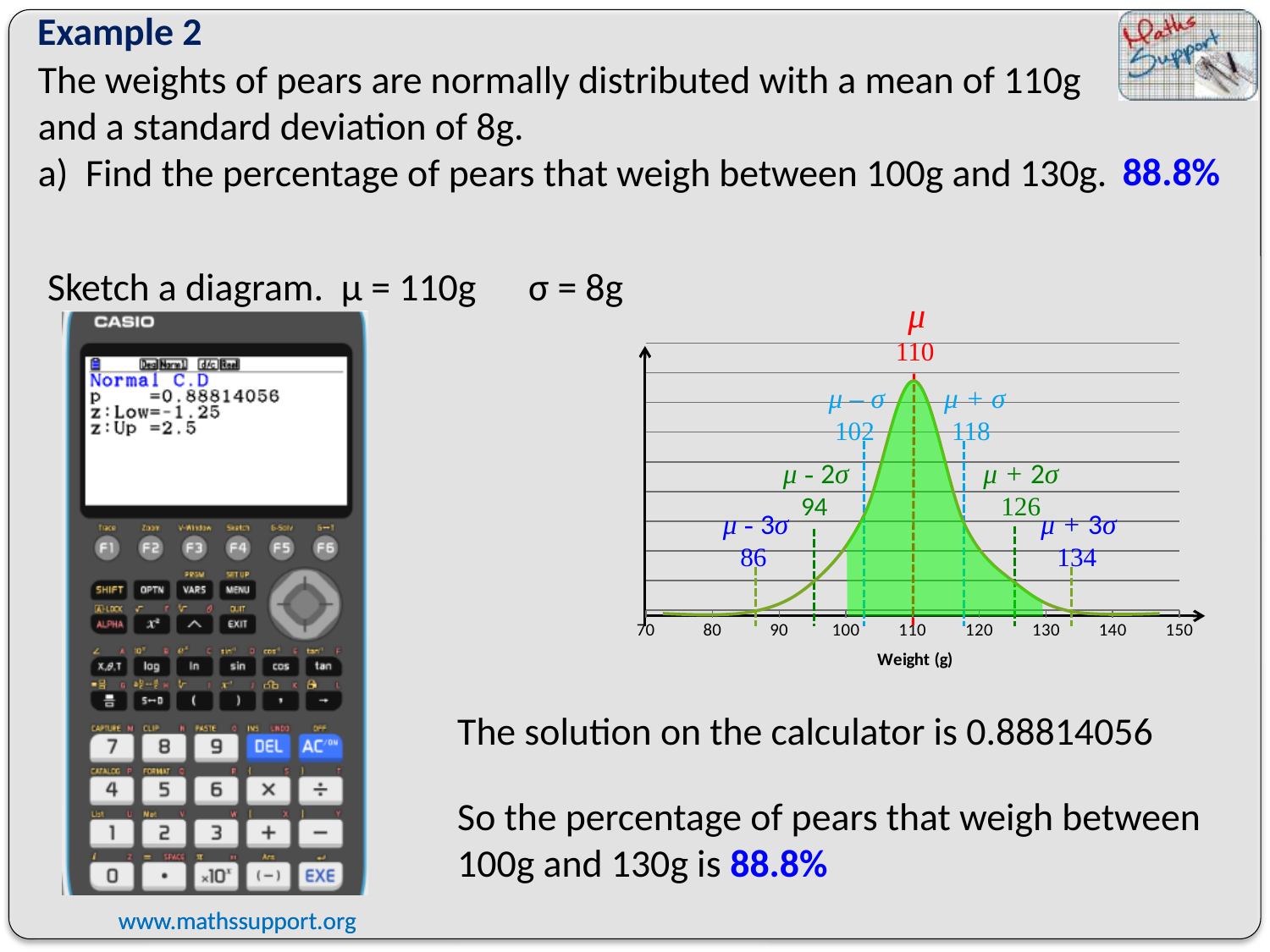
What weight value is marked at μ + σ on the chart? 118 At which weight does the curve on the chart reach its peak? 110 What is the label on the x axis of the chart? Weight (g) What kind of chart is shown on the slide? line chart (normal distribution curve) Which is larger on the chart, the value marked at μ + 2σ or the value marked at μ - 2σ? μ + 2σ (126) Between which two weights on the x axis is the region under the curve shaded green? 100 and 130 How many labelled vertical dashed lines (μ and the σ positions) are drawn on the chart? 7 What weight value is marked at μ + 3σ on the chart? 134 Is the value marked at μ - 3σ on the chart greater or less than 90? less What weight value is marked at μ - 2σ on the chart? 94 What weight value is marked at μ on the chart? 110 What is the difference between the values marked at μ + σ and μ - σ on the chart? 16